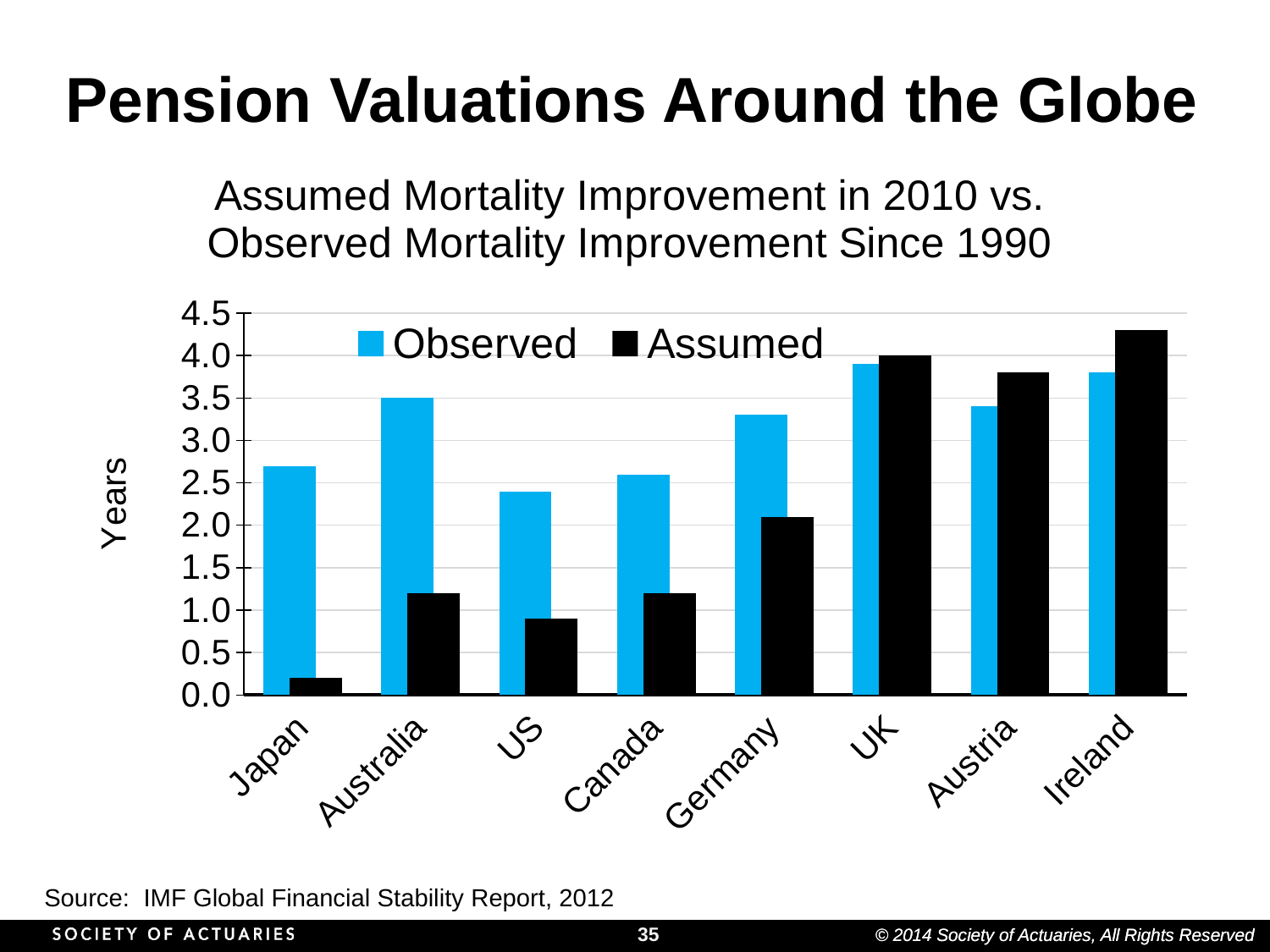
Which country has the lowest Observed value? US Is the Assumed value for Germany greater or less than 2.5? less How many countries are shown on the x axis of the chart? 8 Which country has the lowest Assumed value? Japan Which is larger for Australia, the Observed value or the Assumed value? Observed What is the label on the vertical axis of the chart? Years What are the two series named in the chart's legend? Observed and Assumed Which country has the highest Assumed value? Ireland Is the Observed value for Japan greater or less than 2.5? greater What kind of chart is shown on the slide? bar chart Which is larger for Ireland, the Observed value or the Assumed value? Assumed How many series does the chart's legend list? 2